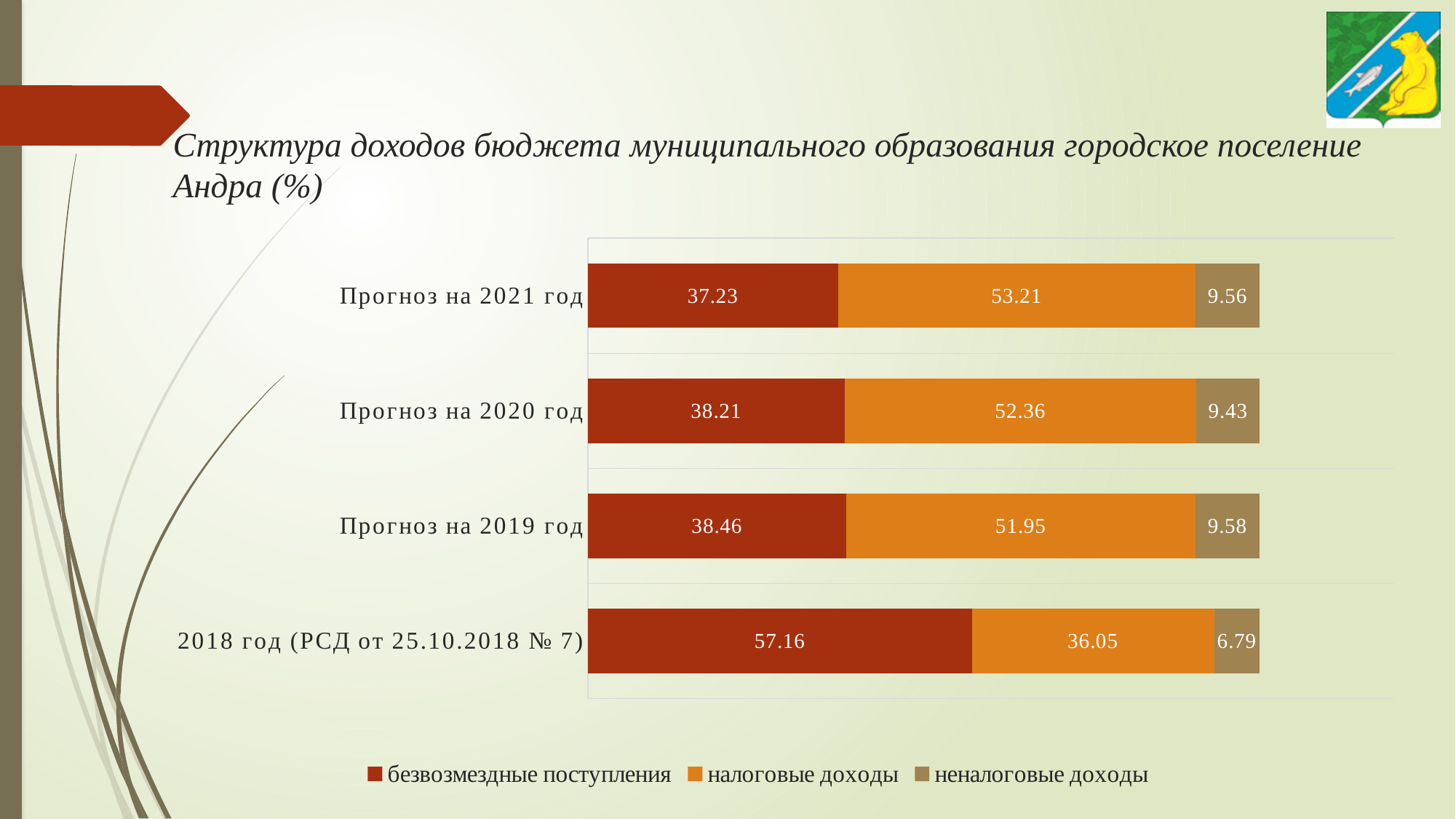
How many series does the legend list? 3 Which category has the lowest value for неналоговые доходы? 2018 год (РСД от 25.10.2018 № 7) Which is larger: налоговые доходы for Прогноз на 2021 год or for Прогноз на 2019 год? Прогноз на 2021 год What is the value of неналоговые доходы for Прогноз на 2019 год? 9.58 What is the value of налоговые доходы for 2018 год (РСД от 25.10.2018 № 7)? 36.05 Which category has the highest value for безвозмездные поступления? 2018 год (РСД от 25.10.2018 № 7) What is the total of the stacked bar for Прогноз на 2020 год? 100.00 What kind of chart is shown on the slide? Stacked bar chart Which series is shown in dark red on the chart? безвозмездные поступления What is the difference between безвозмездные поступления for 2018 год (РСД от 25.10.2018 № 7) and for Прогноз на 2021 год? 19.93 How many categories are shown on the chart? 4 What is the value of безвозмездные поступления for Прогноз на 2021 год? 37.23